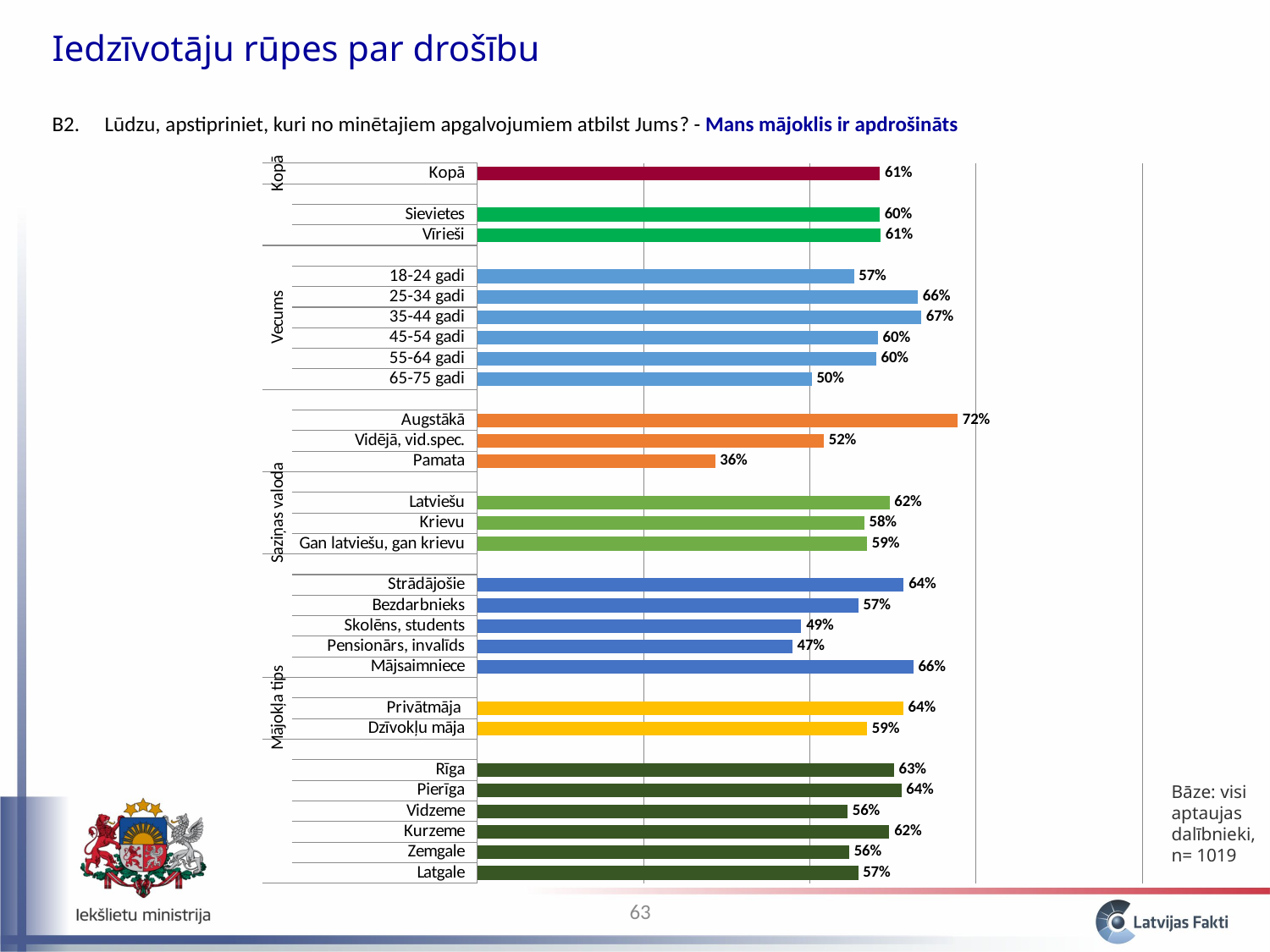
Which category has the lowest value on the chart? Pamata What is the value for Pamata? 36% Which category has the highest value on the chart? Augstākā What is the difference between the values for 35-44 gadi and 65-75 gadi? 17% How many bars are plotted on the chart? 28 What is the value for Mājsaimniece? 66% Which is larger, the value for Privātmāja or the value for Dzīvokļu māja? Privātmāja Which is larger, the value for Latviešu or the value for Krievu? Latviešu What is the value for Kopā? 61% What kind of chart is shown on the slide? Bar chart Which age group has the lowest value among the Vecums categories? 65-75 gadi What is the difference between the values for Augstākā and Pamata? 36%